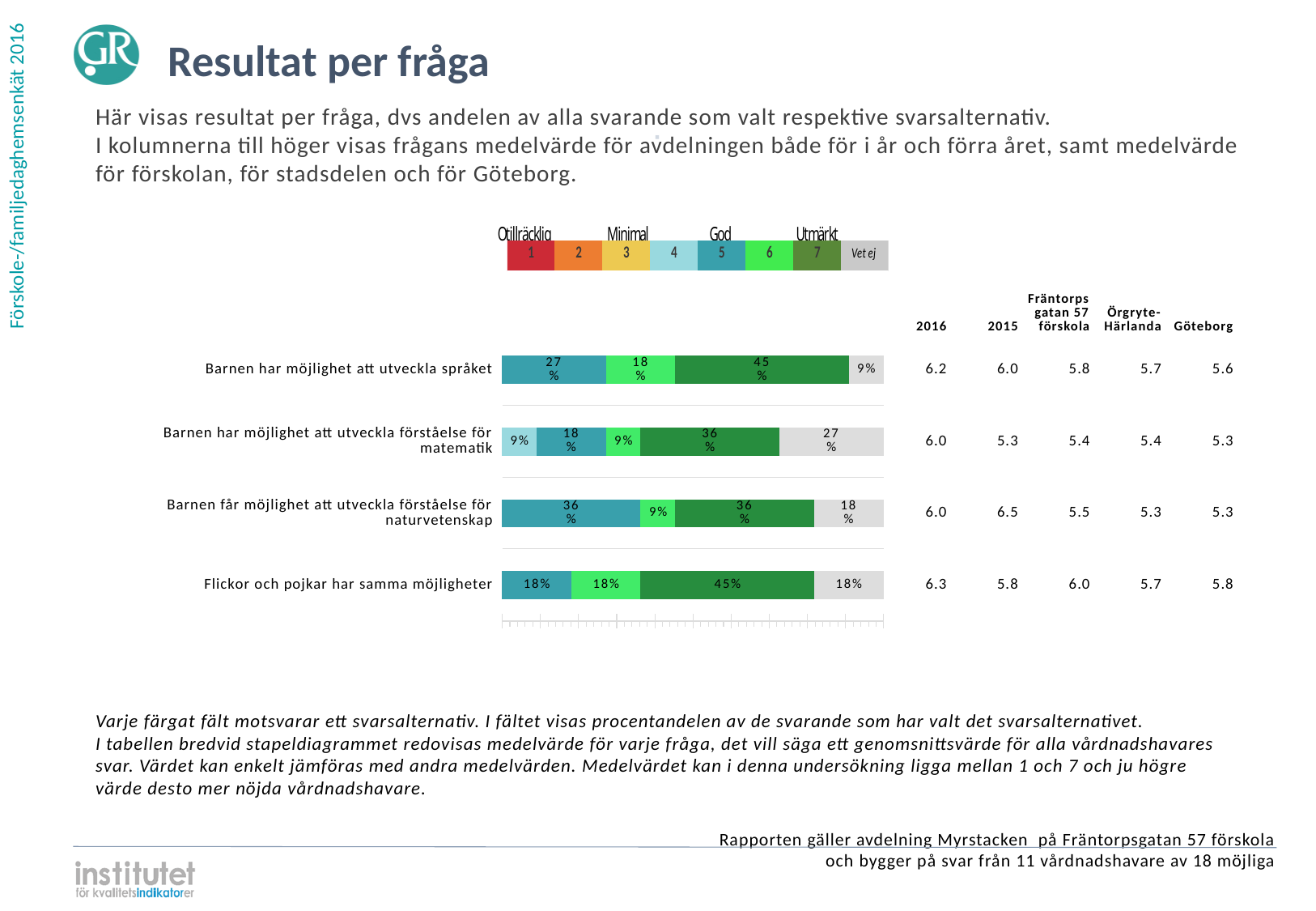
Which question has the smallest 'Vet ej' share? Barnen har möjlighet att utveckla språket Which question has the largest 'Vet ej' share? Barnen har möjlighet att utveckla förståelse för matematik What kind of chart is used to show the results per question? Stacked bar chart Is the dark green (7) share larger for 'Barnen har möjlighet att utveckla språket' or for 'Barnen har möjlighet att utveckla förståelse för matematik'? Barnen har möjlighet att utveckla språket What percentage of respondents chose the dark green option (7, Utmärkt) for 'Barnen har möjlighet att utveckla språket'? 45% What percentage chose 'Vet ej' for 'Barnen har möjlighet att utveckla förståelse för matematik'? 27% What percentage chose the dark green option (7) for 'Flickor och pojkar har samma möjligheter'? 45% For 'Flickor och pojkar har samma möjligheter', how many percentage points larger is the dark green (7) share than the 'Vet ej' share? 27 percentage points What percentage chose the teal option (5) for 'Barnen får möjlighet att utveckla förståelse för naturvetenskap'? 36% How many questions (categories) are shown in the bar chart? 4 What is the 2016 mean value shown for 'Flickor och pojkar har samma möjligheter'? 6.3 How many answer options does the legend above the chart list, including 'Vet ej'? 8